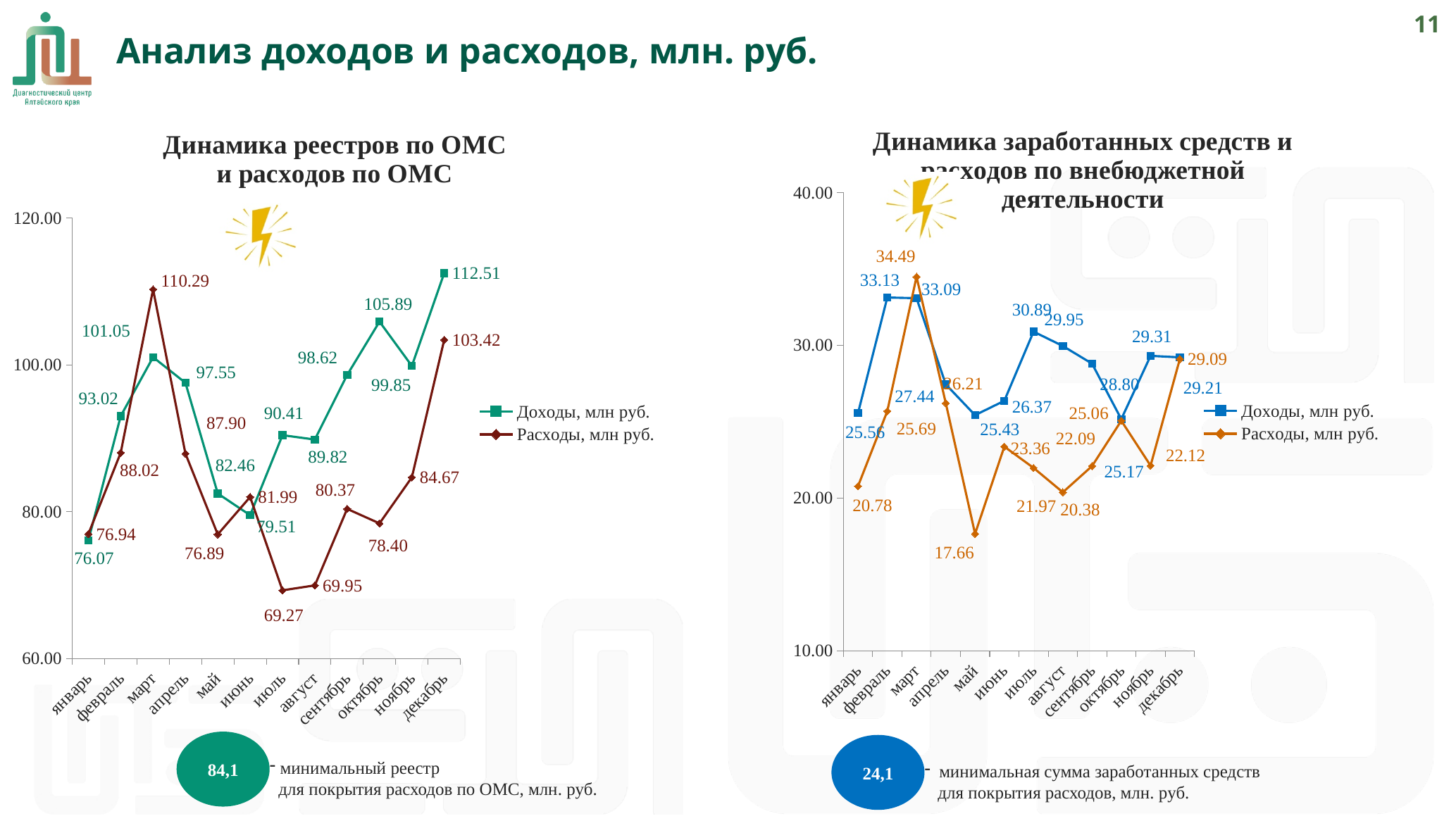
On the left chart, how many months are plotted along the x axis? 12 What type of chart is the left chart? line chart On the left chart, what is the value of Расходы in март? 110.29 On the left chart, which is larger in март: Доходы or Расходы? Расходы On the right chart, what is the difference between Доходы and Расходы in май? 7.77 On the left chart (Динамика реестров по ОМС и расходов по ОМС), what is the value of Доходы in декабрь? 112.51 How many series does the legend of the right chart list? 2 On the left chart, in which month is Расходы lowest? июль On the right chart (Динамика заработанных средств и расходов по внебюджетной деятельности), what is the value of Расходы in май? 17.66 On the right chart, what is the value of Доходы in февраль? 33.13 On the left chart, what is the difference between Доходы and Расходы in октябрь? 27.49 On the right chart, in which month is Расходы highest? март